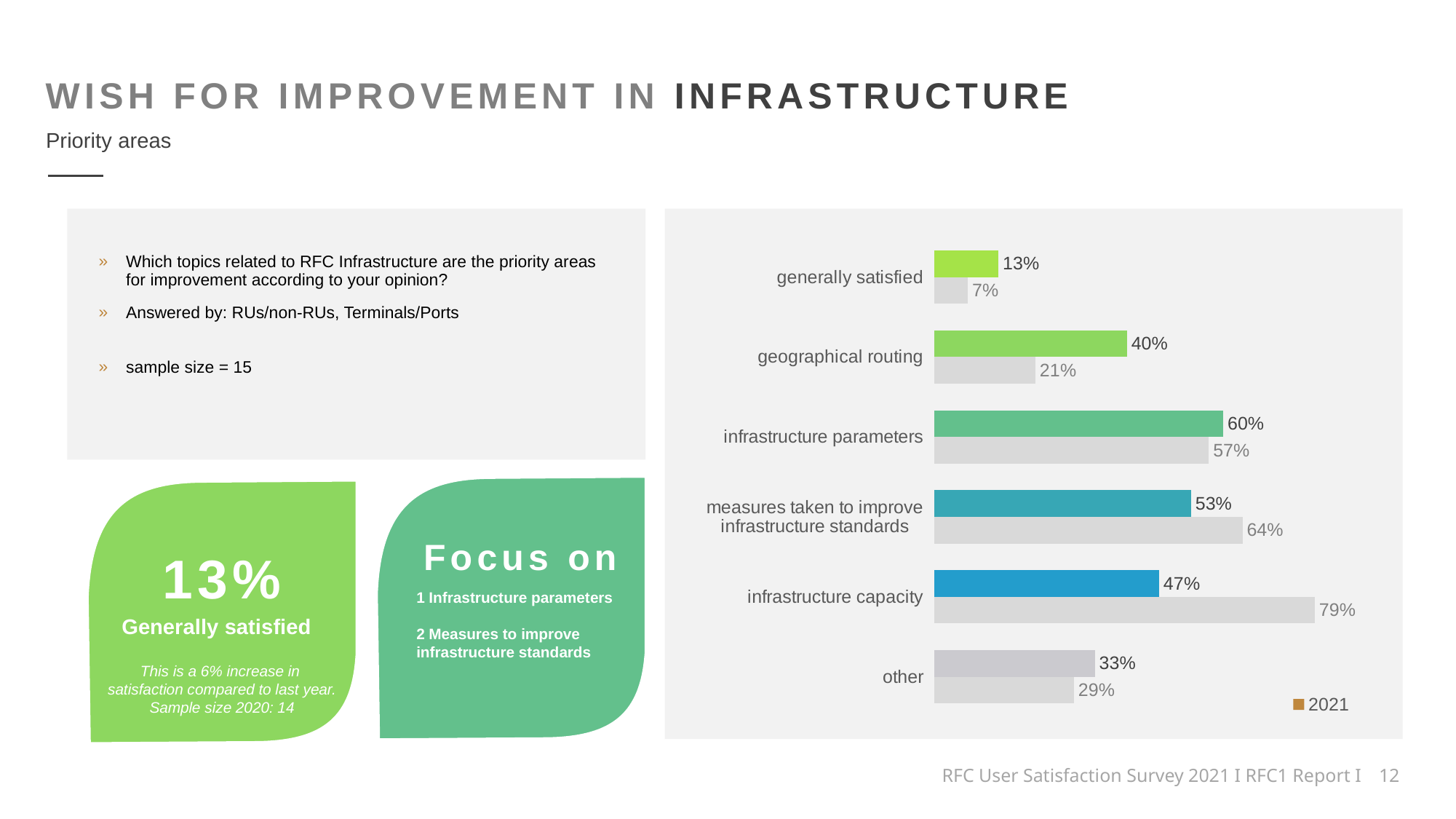
What is the difference between the 2021 value and the grey bar value for infrastructure capacity? 32% Which category has the highest 2021 value? infrastructure parameters What is the 2021 value for infrastructure parameters? 60% How many categories are shown in the chart? 6 What kind of chart is shown on the slide? bar chart Which category has the lowest 2021 value? generally satisfied How many series does the chart legend list? 1 What is the 2021 value for geographical routing? 40% What is the value shown on the grey bar for generally satisfied? 7% For measures taken to improve infrastructure standards, which is larger: the 2021 value or the grey bar value? the grey bar value What is the difference between the 2021 values for infrastructure parameters and geographical routing? 20% What is the value shown on the grey bar for infrastructure capacity? 79%